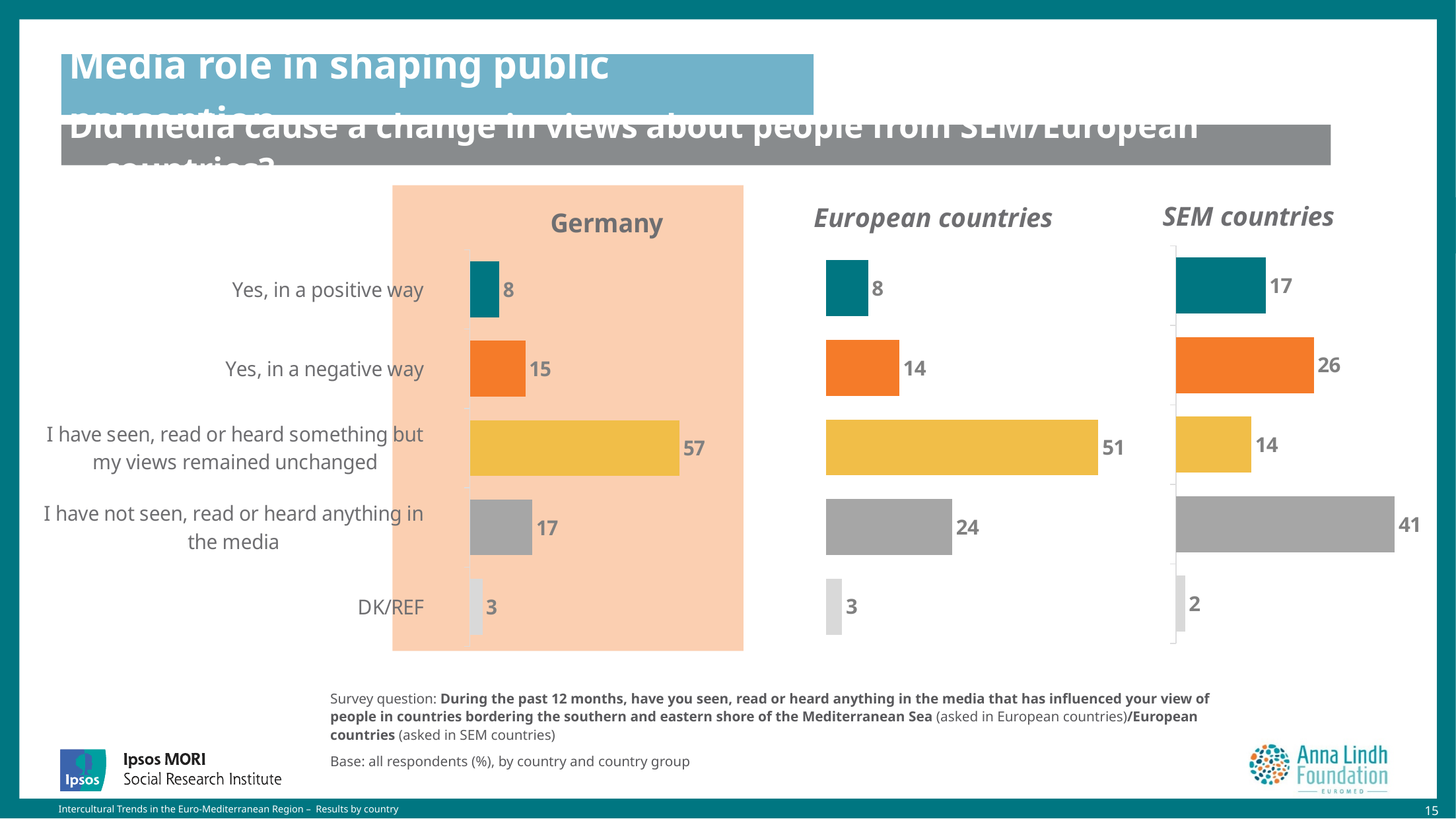
In the European countries chart, what is the value for "I have not seen, read or heard anything in the media"? 24 How many categories are shown in the Germany chart? 5 In the European countries chart, what is the difference between "I have seen, read or heard something but my views remained unchanged" and "I have not seen, read or heard anything in the media"? 27 In the SEM countries chart, which category has the highest value? I have not seen, read or heard anything in the media What type of chart is used for the European countries data? bar chart In the Germany chart, what is the value for "I have seen, read or heard something but my views remained unchanged"? 57 In the SEM countries chart, what is the difference between "Yes, in a negative way" and "Yes, in a positive way"? 9 In the Germany chart, which category has the lowest value? DK/REF What colour are the bars for "Yes, in a negative way" across the three charts? orange Which is larger: the value for "Yes, in a negative way" in the Germany chart or in the European countries chart? Germany In the SEM countries chart, what is the value for "Yes, in a negative way"? 26 In the SEM countries chart, is the value for "Yes, in a positive way" larger or smaller than the value for "I have seen, read or heard something but my views remained unchanged"? larger